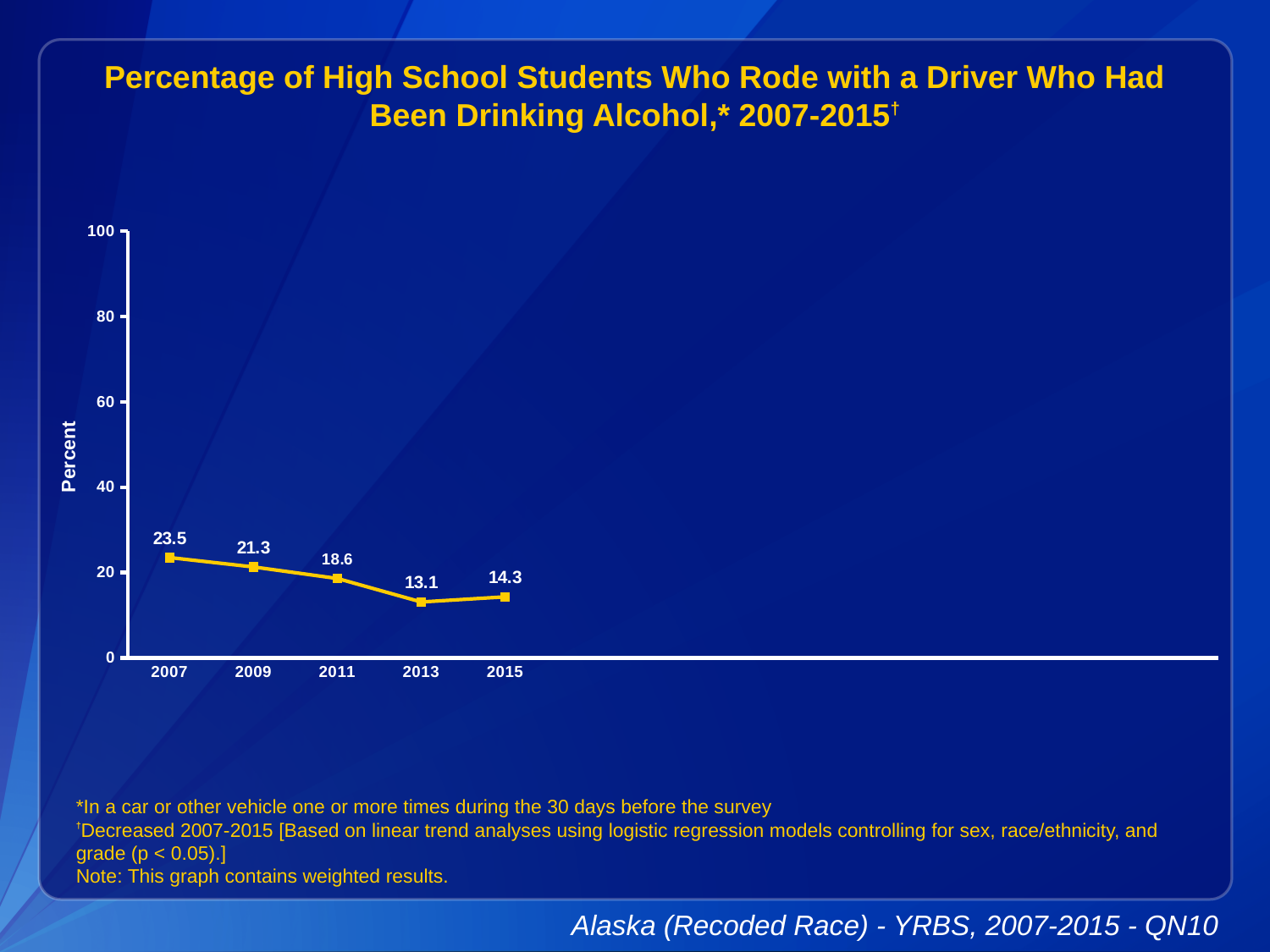
Which year had a higher percentage, 2011 or 2015? 2011 How many years are plotted on the chart? 5 What was the percentage in 2013? 13.1 What is the difference between the 2009 value and the 2011 value? 2.7 Is the value for 2009 greater or less than 20? greater What is the difference between the 2007 value and the 2015 value? 9.2 What is the label on the y axis? Percent What was the percentage of high school students who rode with a driver who had been drinking alcohol in 2007? 23.5 Which year had the highest percentage? 2007 What was the percentage in 2015? 14.3 What kind of chart is shown on the slide? Line chart Which year had the lowest percentage? 2013